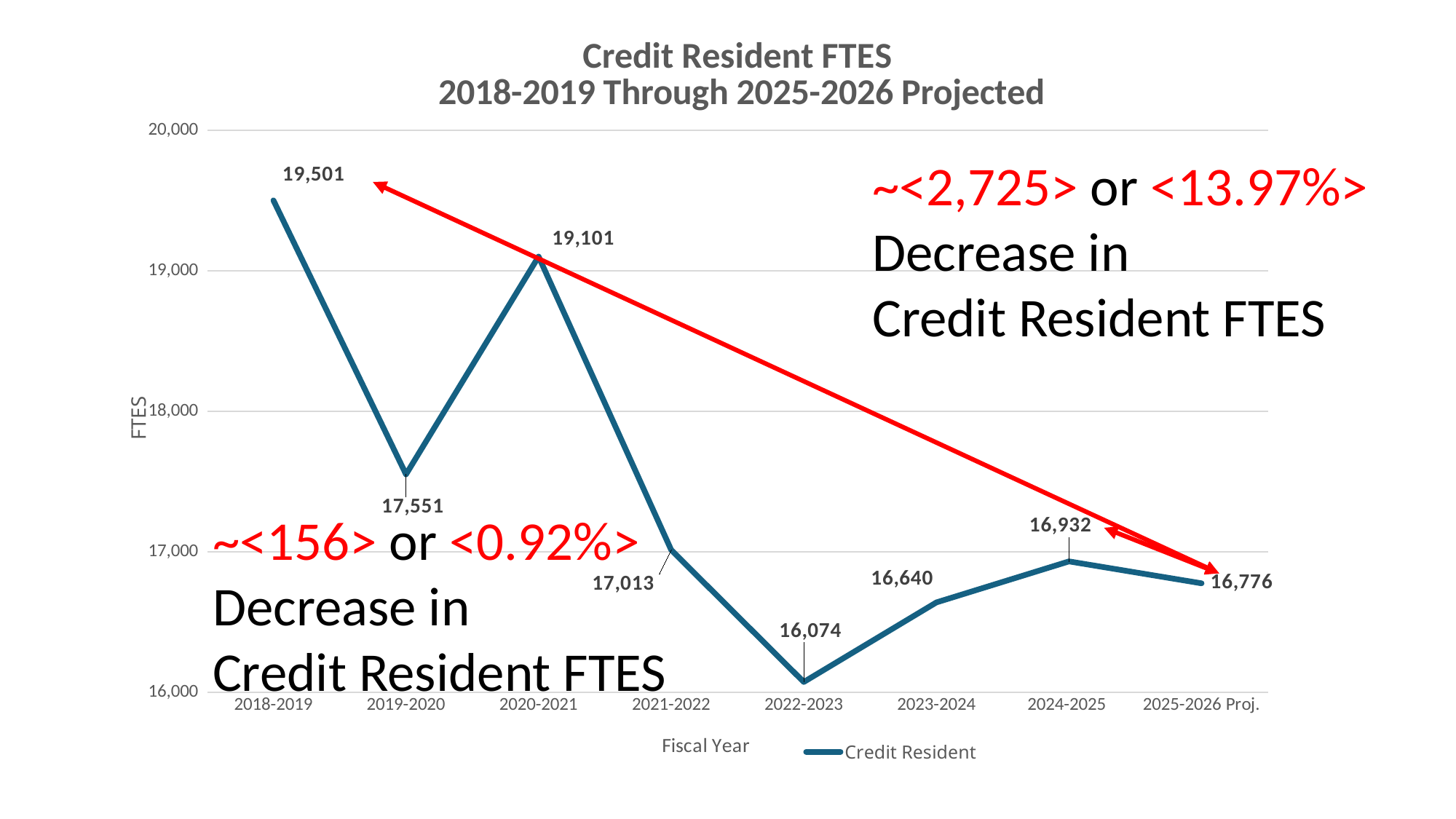
Is the Credit Resident FTES value for 2023-2024 greater or less than 17,000? less What is the title of the chart? Credit Resident FTES 2018-2019 Through 2025-2026 Projected What kind of chart is shown on the slide? Line chart Which fiscal year has the lowest Credit Resident FTES? 2022-2023 What is the difference in Credit Resident FTES between 2018-2019 and 2019-2020? 1,950 How many fiscal years are plotted on the chart? 8 What is the difference in Credit Resident FTES between 2024-2025 and 2025-2026 Proj.? 156 Which fiscal year has the highest Credit Resident FTES? 2018-2019 What is the Credit Resident FTES value for 2018-2019? 19,501 What is the Credit Resident FTES value for 2022-2023? 16,074 What is the projected Credit Resident FTES value for 2025-2026? 16,776 Which is larger, the Credit Resident FTES for 2020-2021 or for 2021-2022? 2020-2021